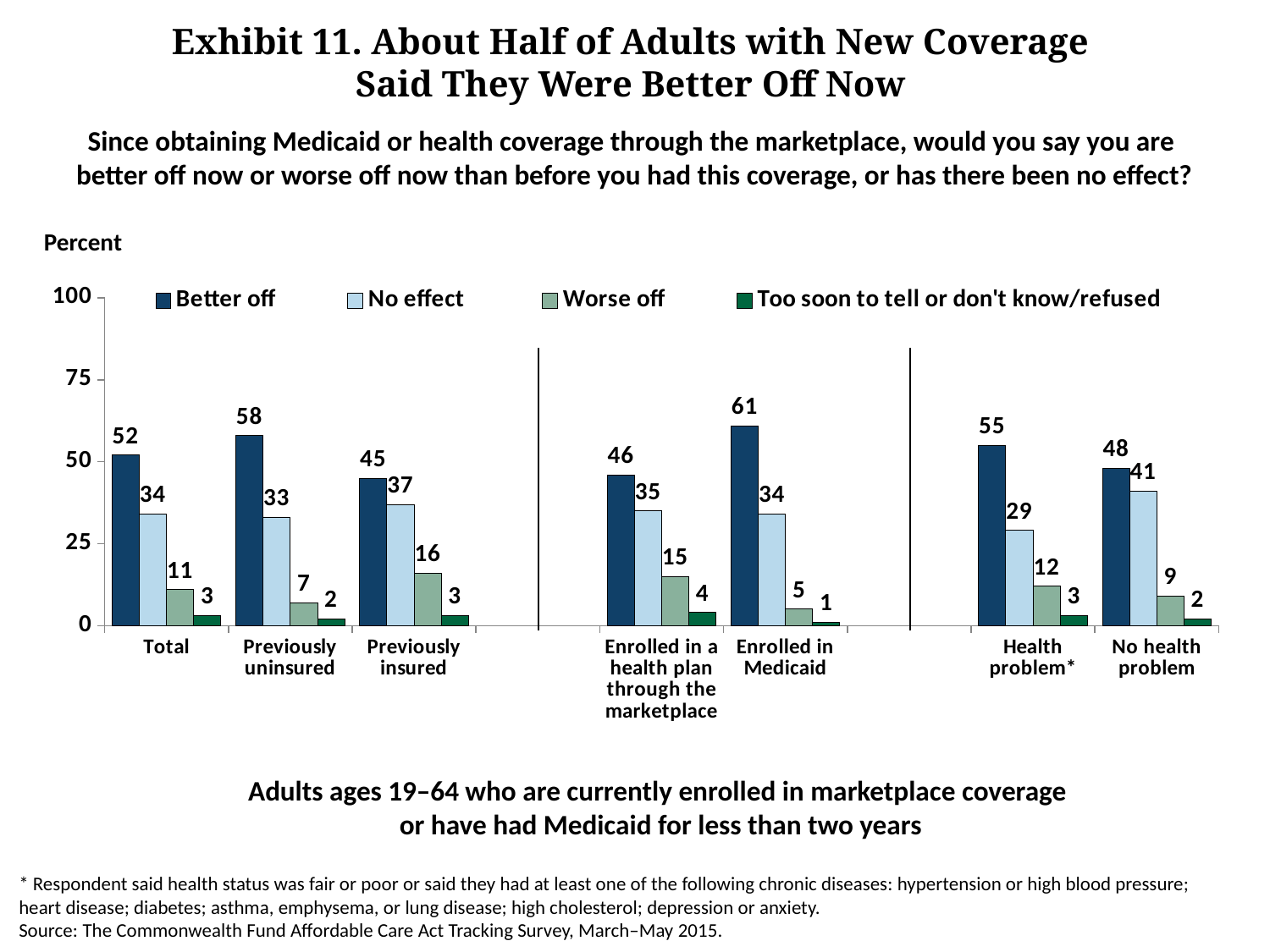
How many series does the legend list? 4 What is the 'Worse off' value for the Previously insured group? 16 Which category has the lowest 'Too soon to tell or don't know/refused' value? Enrolled in Medicaid Which category has the highest 'Better off' value? Enrolled in Medicaid What is the 'No effect' value for adults enrolled in Medicaid? 34 What percentage of the Total group said they were better off? 52 Which is larger: the 'No effect' value for Health problem* or for No health problem? No health problem What is the difference between the 'Better off' values for Previously uninsured and Previously insured? 13 Is the 'Better off' value for Enrolled in a health plan through the marketplace greater or less than 50? less What is the label of the y axis? Percent How many categories are shown on the x axis? 7 What kind of chart is shown on the slide? bar chart